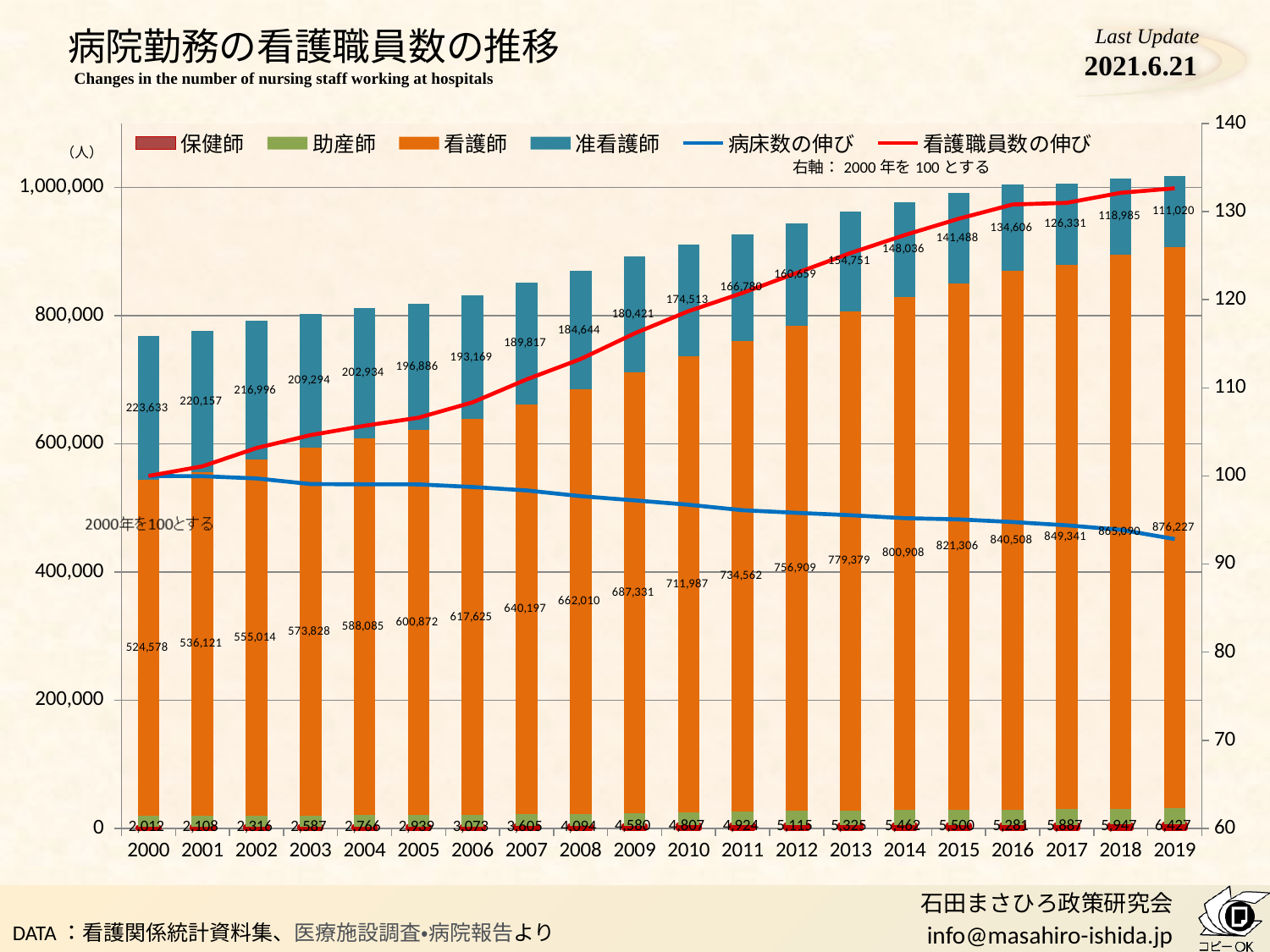
What kind of chart is shown on the slide? stacked bar chart with line series How many years are shown on the x axis of the chart? 20 In which year is the value for 准看護師 the lowest? 2019 In which year is the value for 看護師 the highest? 2019 Which year has the larger value for 准看護師, 2005 or 2006? 2005 What is the value for 看護師 in 2019? 876,227 Do the values for 准看護師 rise or fall from 2000 to 2019? fall What is the difference between the 看護師 values for 2019 and 2000? 351,649 What is the value for 准看護師 in 2000? 223,633 How many series does the legend list? 6 What is the value for 看護師 in 2010? 711,987 Is the value of the 看護職員数の伸び line in 2019 greater or less than 130 on the right axis? greater